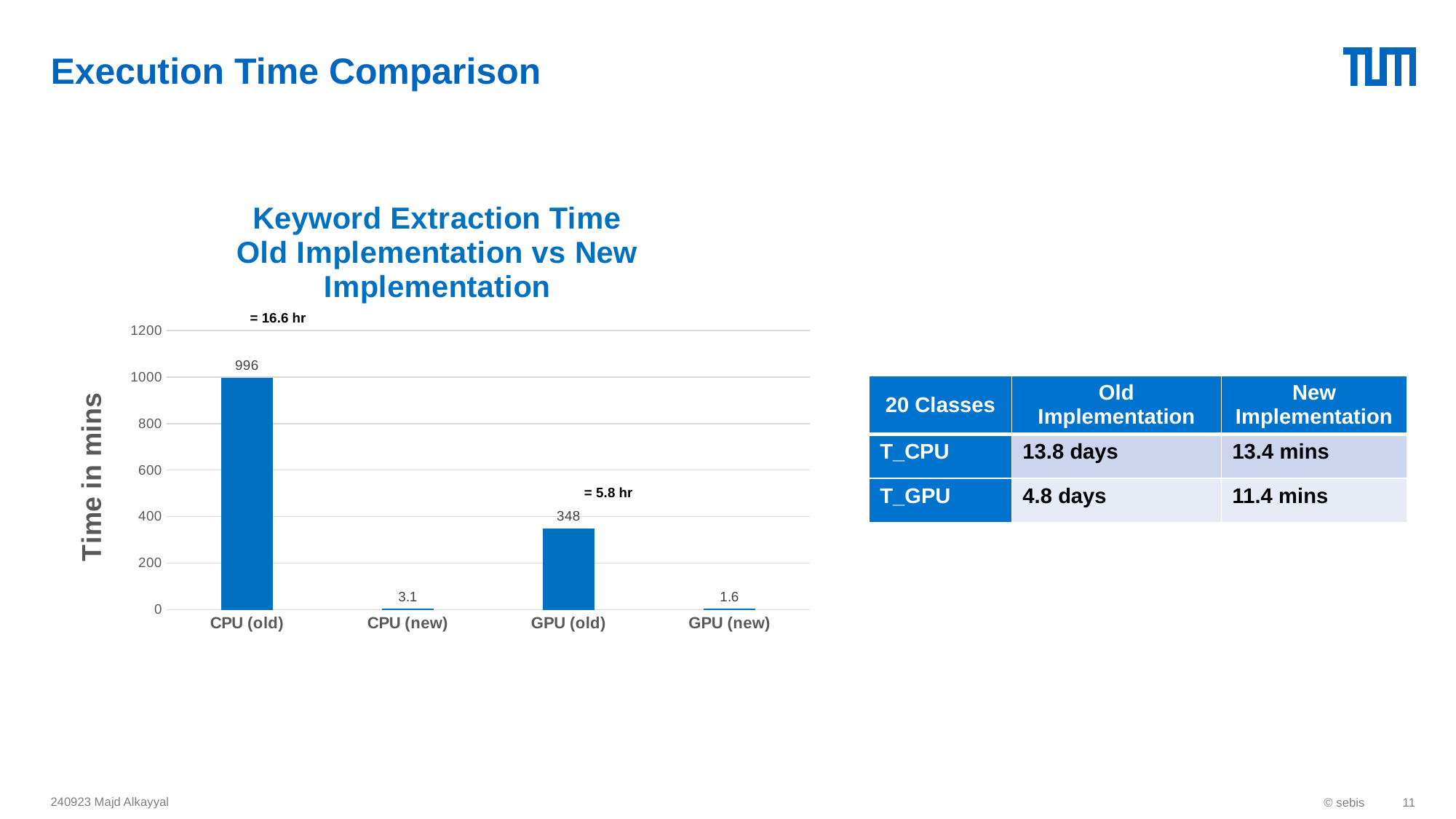
How many categories are shown on the x axis of the Keyword Extraction Time chart? 4 Which is larger in the Keyword Extraction Time chart, CPU (new) or GPU (new)? CPU (new) What is the difference between the CPU (old) and GPU (old) values in the Keyword Extraction Time chart? 648 What is the value for CPU (old) in the Keyword Extraction Time chart? 996 What is the value for GPU (old) in the Keyword Extraction Time chart? 348 Which category has the lowest value in the Keyword Extraction Time chart? GPU (new) What kind of chart is the Keyword Extraction Time chart? bar chart What annotation in hours is shown above the GPU (old) bar in the Keyword Extraction Time chart? = 5.8 hr What is the value for CPU (new) in the Keyword Extraction Time chart? 3.1 What is the value for GPU (new) in the Keyword Extraction Time chart? 1.6 What is the y-axis label of the Keyword Extraction Time chart? Time in mins Which category has the highest value in the Keyword Extraction Time chart? CPU (old)